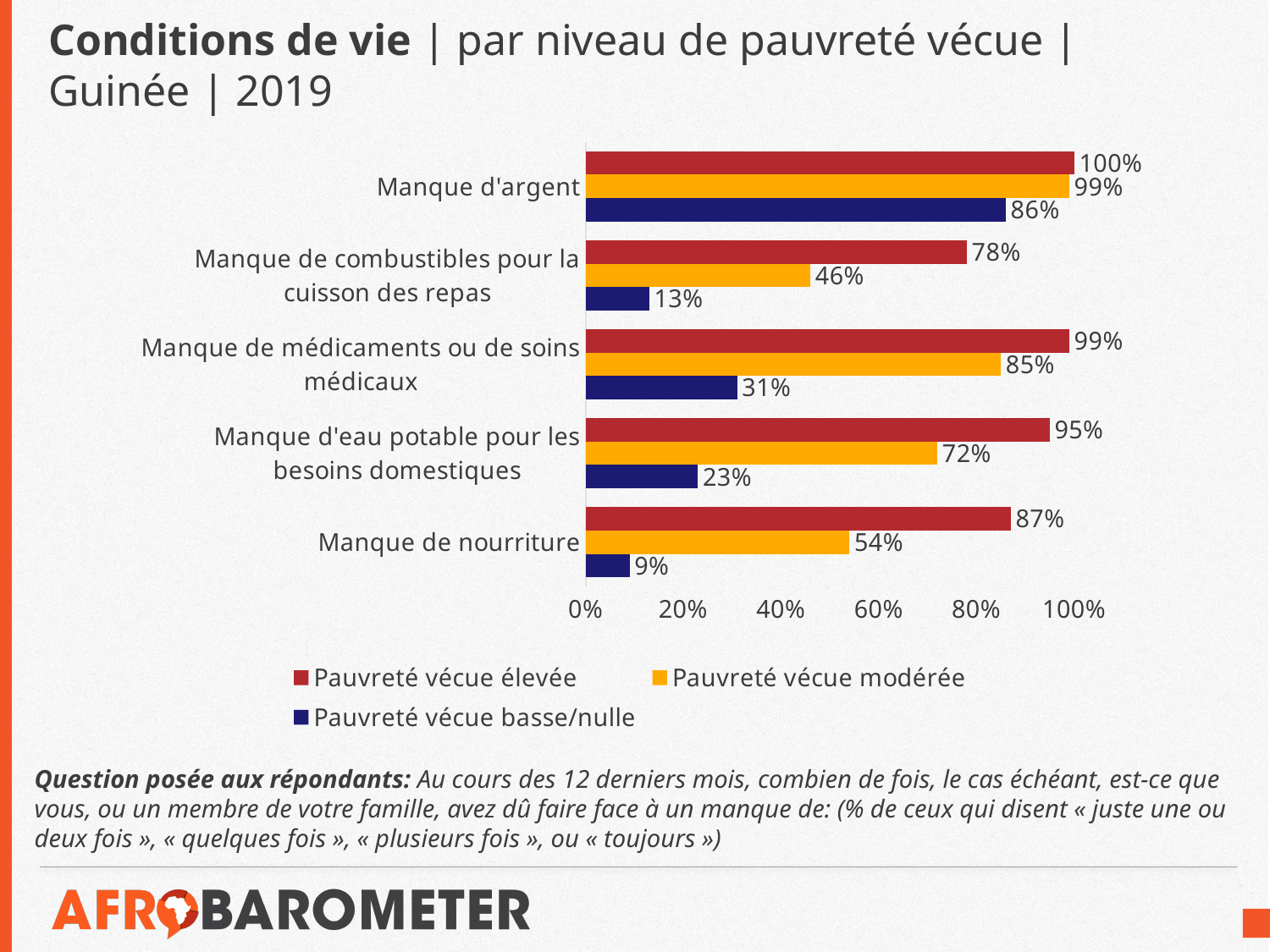
What is the value for "Pauvreté vécue basse/nulle" in the "Manque de nourriture" category? 9% What is the value for "Pauvreté vécue modérée" in the "Manque de combustibles pour la cuisson des repas" category? 46% Which is larger: the "Pauvreté vécue modérée" value for "Manque de nourriture" or for "Manque d'eau potable pour les besoins domestiques"? Manque d'eau potable pour les besoins domestiques Which category has the highest value for "Pauvreté vécue basse/nulle"? Manque d'argent How many series does the legend list? 3 What is the value for "Pauvreté vécue élevée" in the "Manque d'eau potable pour les besoins domestiques" category? 95% What kind of chart is shown on the slide? bar chart What is the difference between the "Pauvreté vécue élevée" and "Pauvreté vécue basse/nulle" values for "Manque de médicaments ou de soins médicaux"? 68% Is the value for "Pauvreté vécue basse/nulle" in "Manque de médicaments ou de soins médicaux" greater or less than 40%? less Which colour represents "Pauvreté vécue élevée" in the chart? red Which category has the lowest value for "Pauvreté vécue modérée"? Manque de combustibles pour la cuisson des repas How many categories are shown on the chart? 5